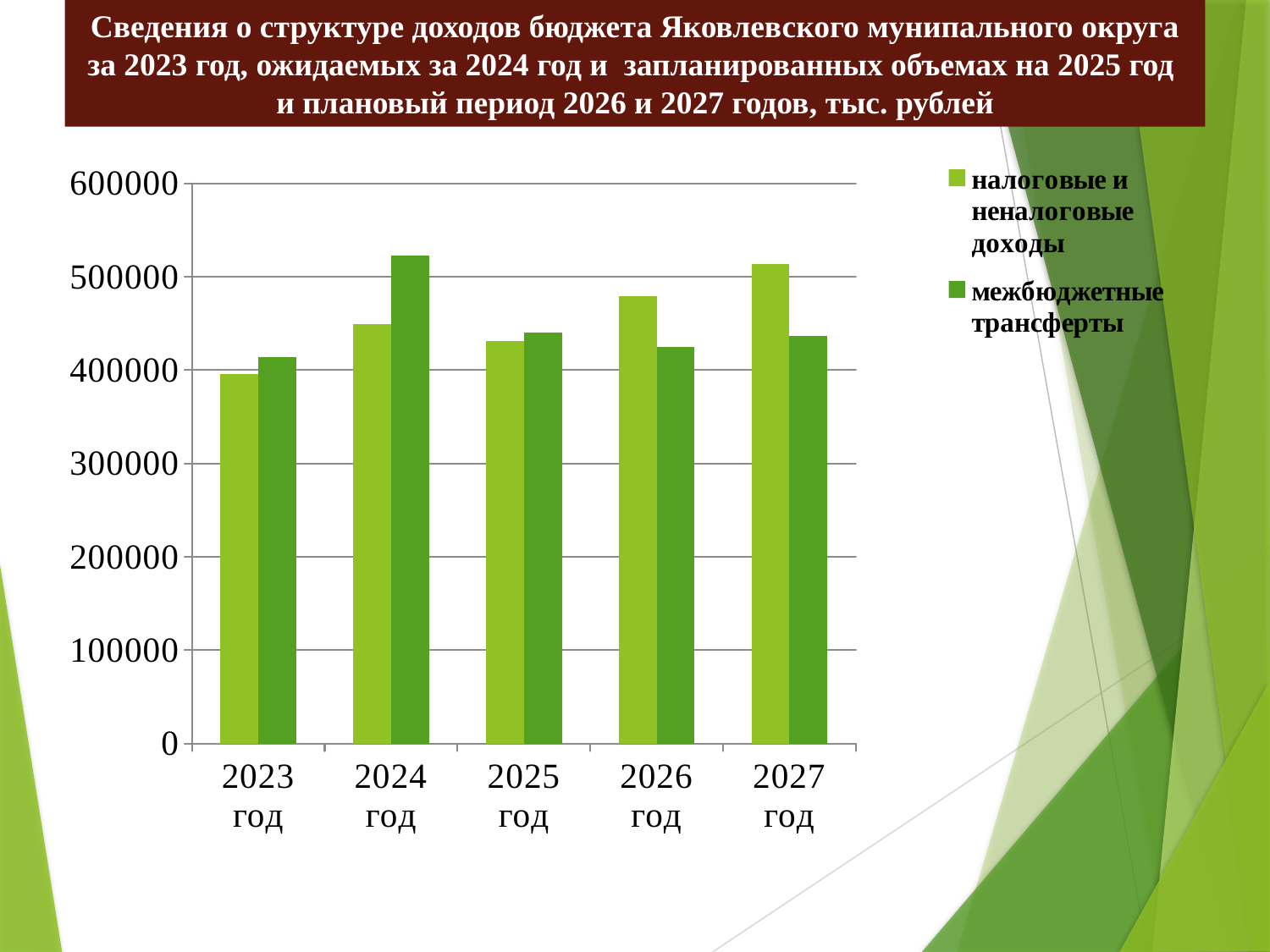
In 2024 год, which is larger: налоговые и неналоговые доходы or межбюджетные трансферты? межбюджетные трансферты Is the value for налоговые и неналоговые доходы in 2025 год greater or less than 400000? greater Does the value for налоговые и неналоговые доходы rise or fall from 2025 год to 2027 год? rise How many series does the chart legend list? 2 In which year is the value for налоговые и неналоговые доходы the highest? 2027 год In which year is the value for межбюджетные трансферты the highest? 2024 год Is the value for налоговые и неналоговые доходы in 2026 год greater or less than 500000? less In 2027 год, which is larger: налоговые и неналоговые доходы or межбюджетные трансферты? налоговые и неналоговые доходы Is the value for межбюджетные трансферты in 2024 год greater or less than 500000? greater What kind of chart is shown on the slide? bar chart In which year is the value for налоговые и неналоговые доходы the lowest? 2023 год How many years are shown on the x axis of the chart? 5